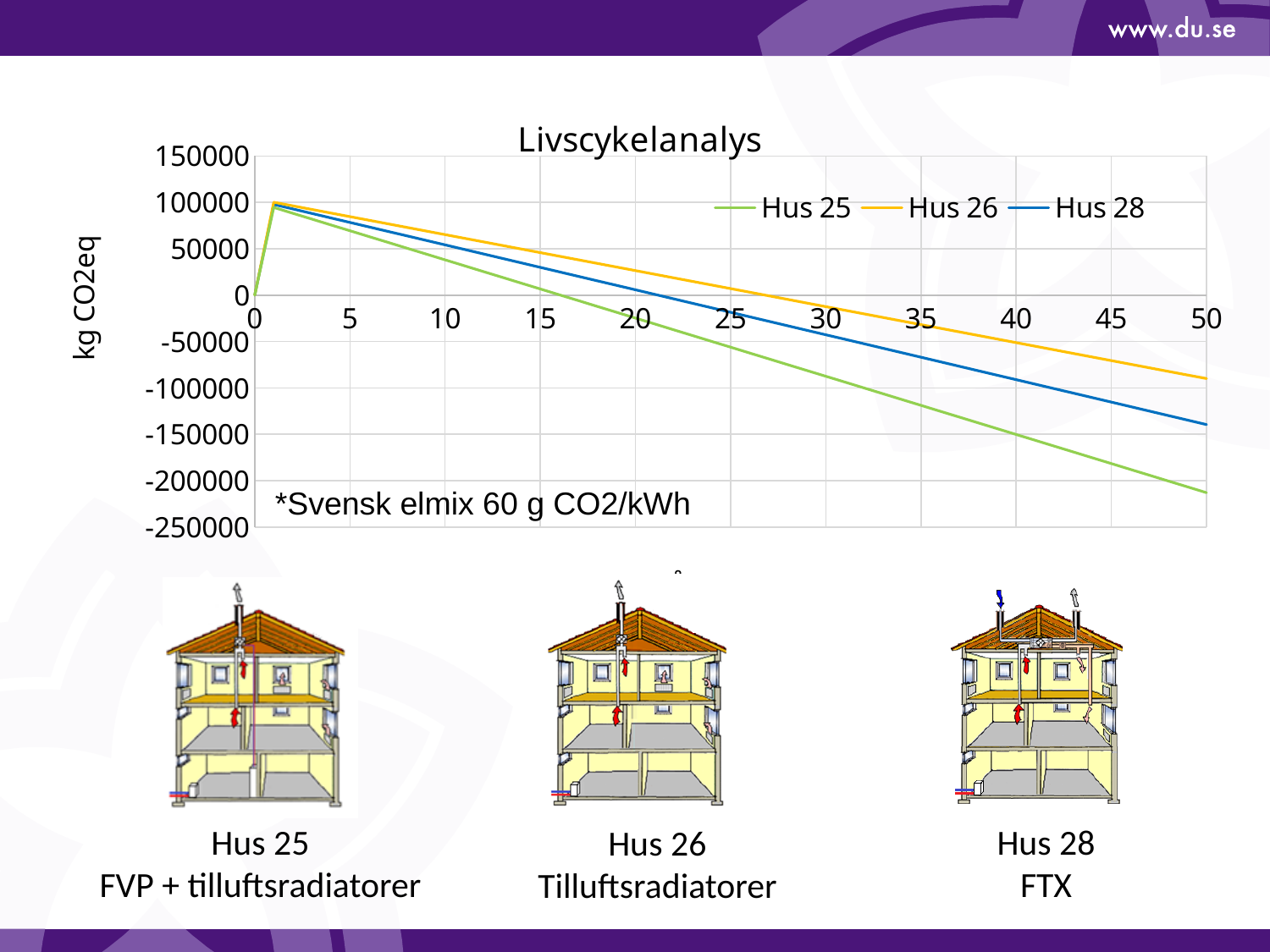
How many series does the legend of the Livscykelanalys chart list? 3 At x = 50, which series has the larger value, Hus 26 or Hus 25? Hus 26 Is the value for Hus 26 at x = 50 greater or less than -50000? less Is the value for Hus 28 at x = 50 greater or less than -100000? less At x = 30, which series has the larger value, Hus 28 or Hus 25? Hus 28 Which series has the highest value at x = 50 in the Livscykelanalys chart? Hus 26 After the initial peak near x = 1, do the values of the three series rise or fall as x increases toward 50? fall Which series has the lowest value at x = 50 in the Livscykelanalys chart? Hus 25 What is the title of the chart? Livscykelanalys What is the label on the vertical axis of the chart? kg CO2eq What kind of chart is shown on the slide? line chart Is the value for Hus 25 at x = 50 greater or less than -150000? less